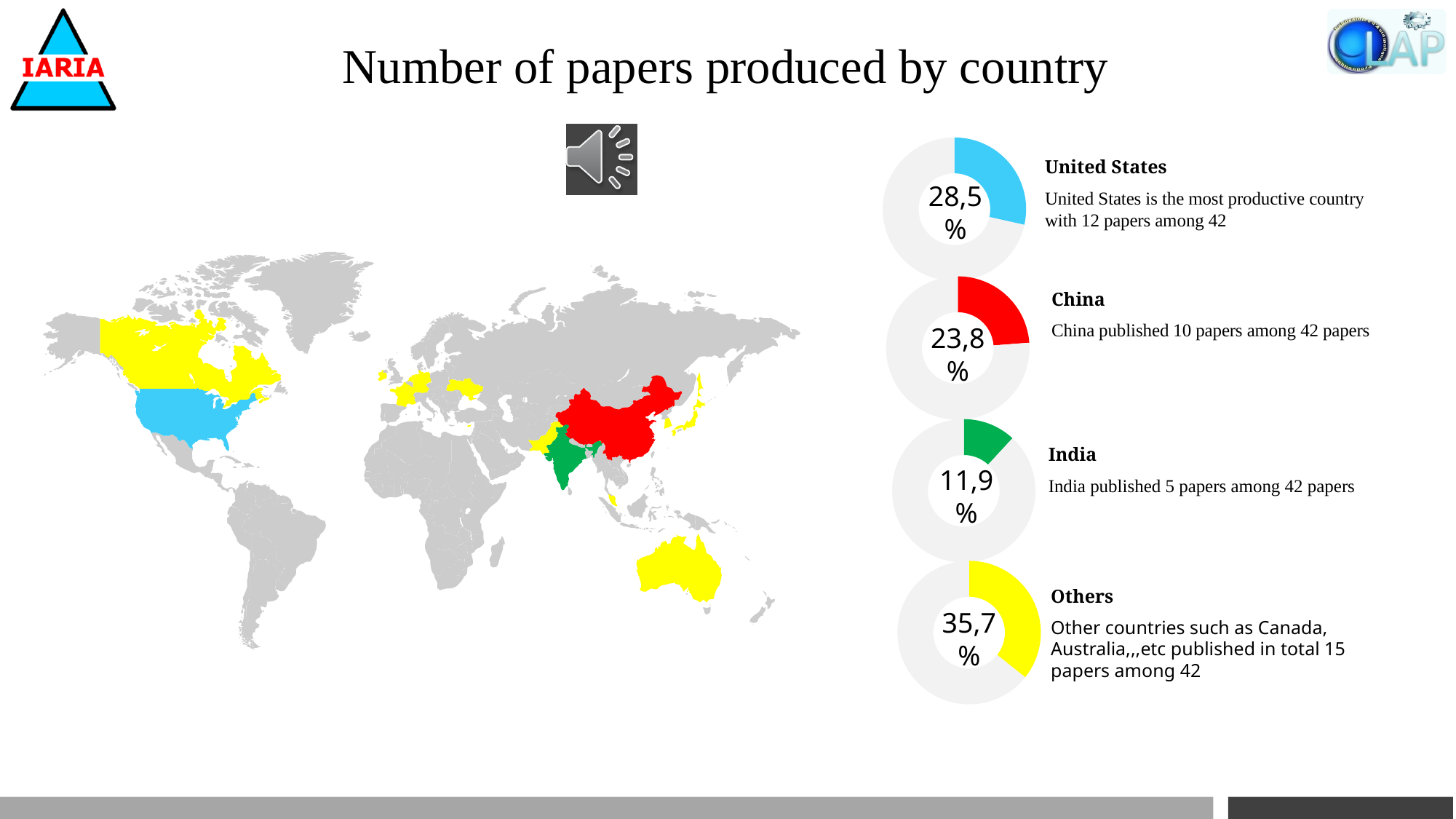
What colour is the filled segment of the China donut chart? Red What is the difference in percentage points between the United States donut chart and the China donut chart? 4,7 What percentage is shown in the India donut chart? 11,9% Among the four donut charts, which category has the highest percentage? Others Among the four donut charts, which category has the lowest percentage? India What percentage is shown in the United States donut chart? 28,5% What percentage is shown in the China donut chart? 23,8% What percentage is shown in the Others donut chart? 35,7% What kind of chart is used to show each country's share of papers? Donut chart How many donut charts are shown on the slide? 4 Which has a larger percentage in the donut charts, United States or China? United States What colour is the filled segment of the India donut chart? Green